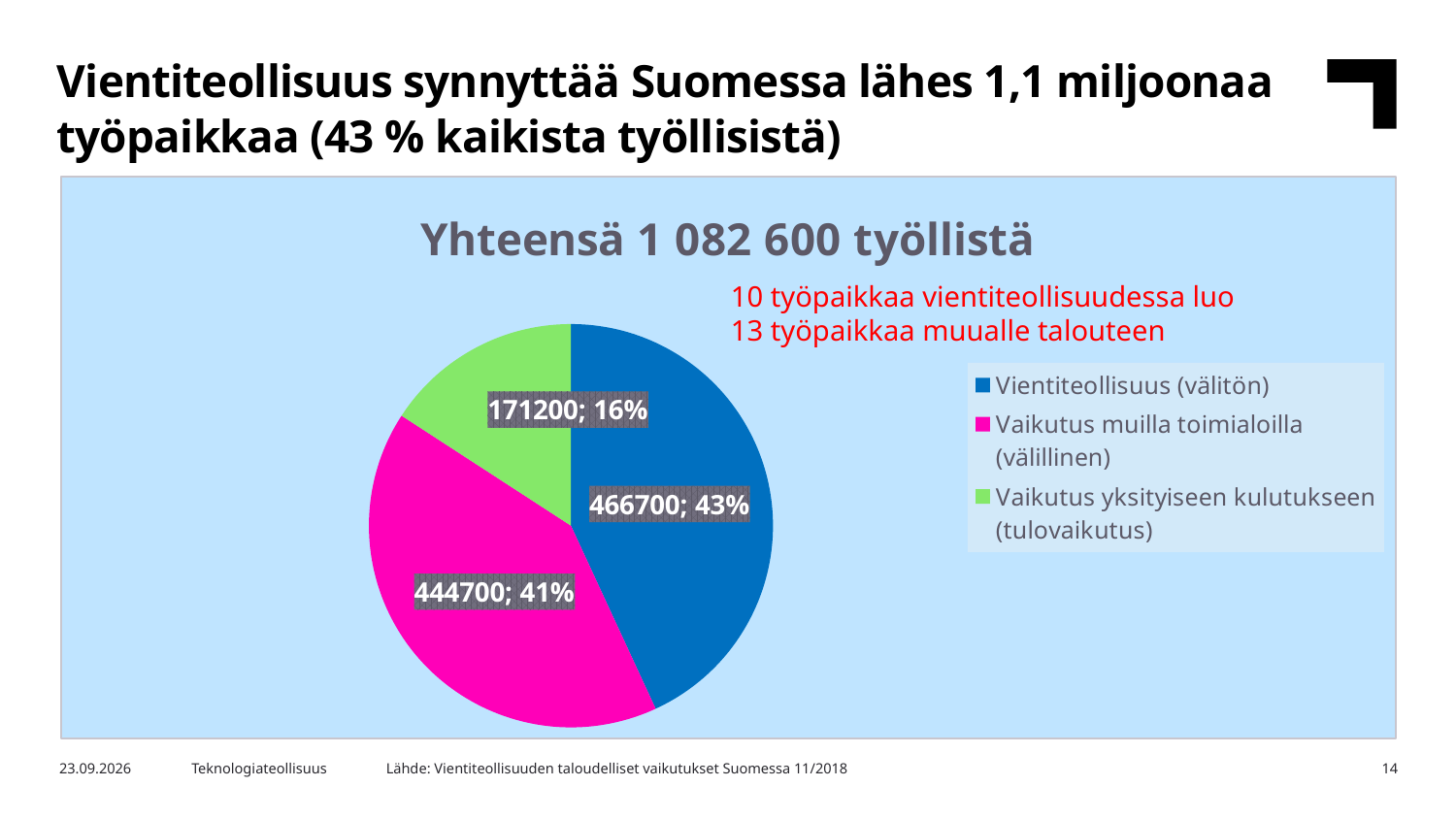
What is the value for Vaikutus muilla toimialoilla (välillinen)? 444700 Which slice is the largest? Vientiteollisuus (välitön) What share of the pie does Vaikutus yksityiseen kulutukseen (tulovaikutus) represent? 16% What share of the pie does Vientiteollisuus (välitön) represent? 43% What is the value for Vientiteollisuus (välitön)? 466700 What is the value for Vaikutus yksityiseen kulutukseen (tulovaikutus)? 171200 What is the difference between the values for Vientiteollisuus (välitön) and Vaikutus muilla toimialoilla (välillinen)? 22000 How many entries does the legend list? 3 Which slice is the smallest? Vaikutus yksityiseen kulutukseen (tulovaikutus) What is the title of the chart? Yhteensä 1 082 600 työllistä How many slices does the pie chart have? 3 What kind of chart is shown on the slide? Pie chart